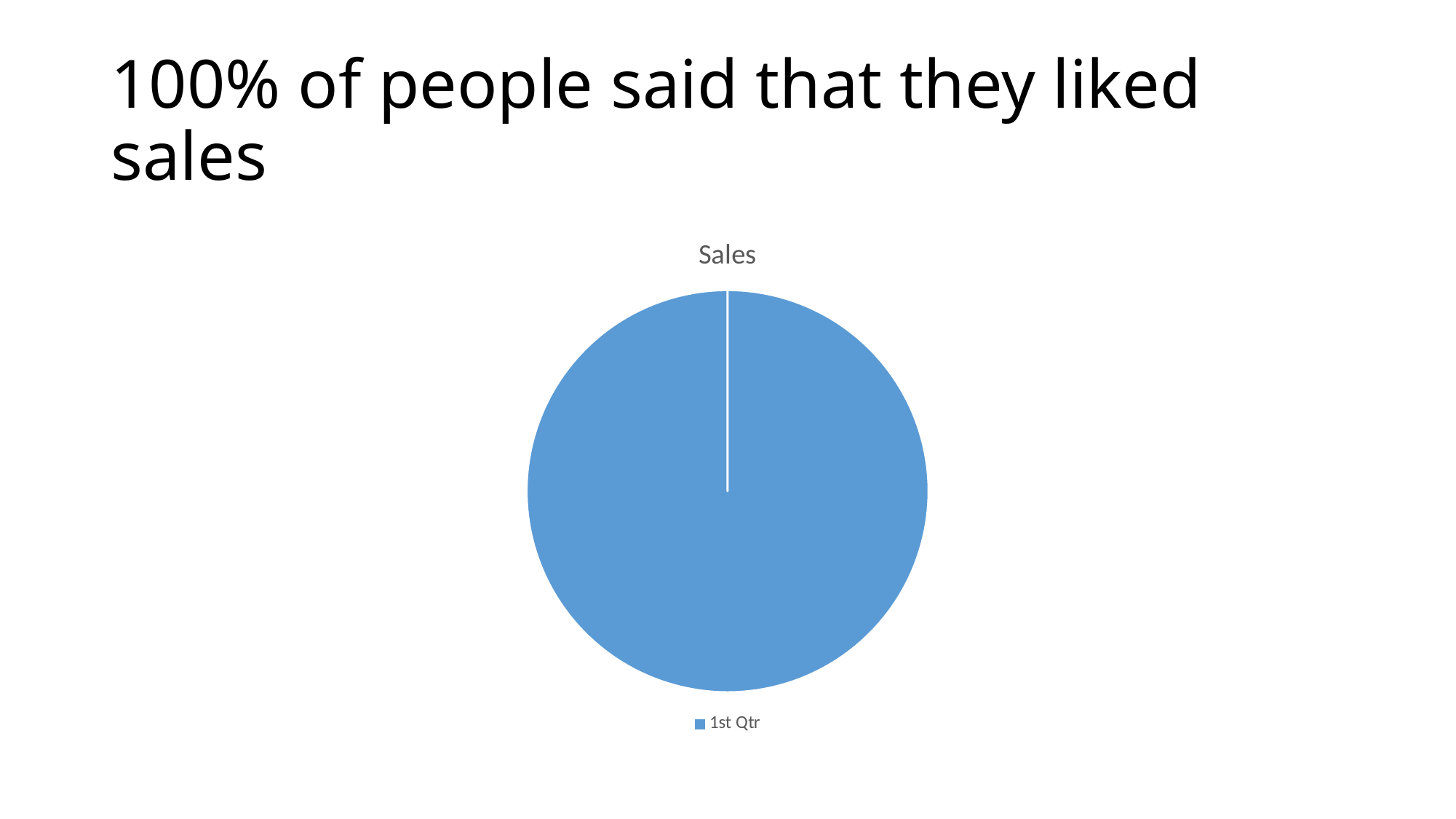
What share of the pie does the 1st Qtr slice take up? 100% How many slices does the pie chart have? 1 What kind of chart is shown on the slide? pie chart What is the title of the chart? Sales Which category has the largest slice in the pie chart? 1st Qtr What colour is the 1st Qtr slice in the pie chart? blue How many entries does the chart legend list? 1 What is the label of the only slice in the pie chart? 1st Qtr